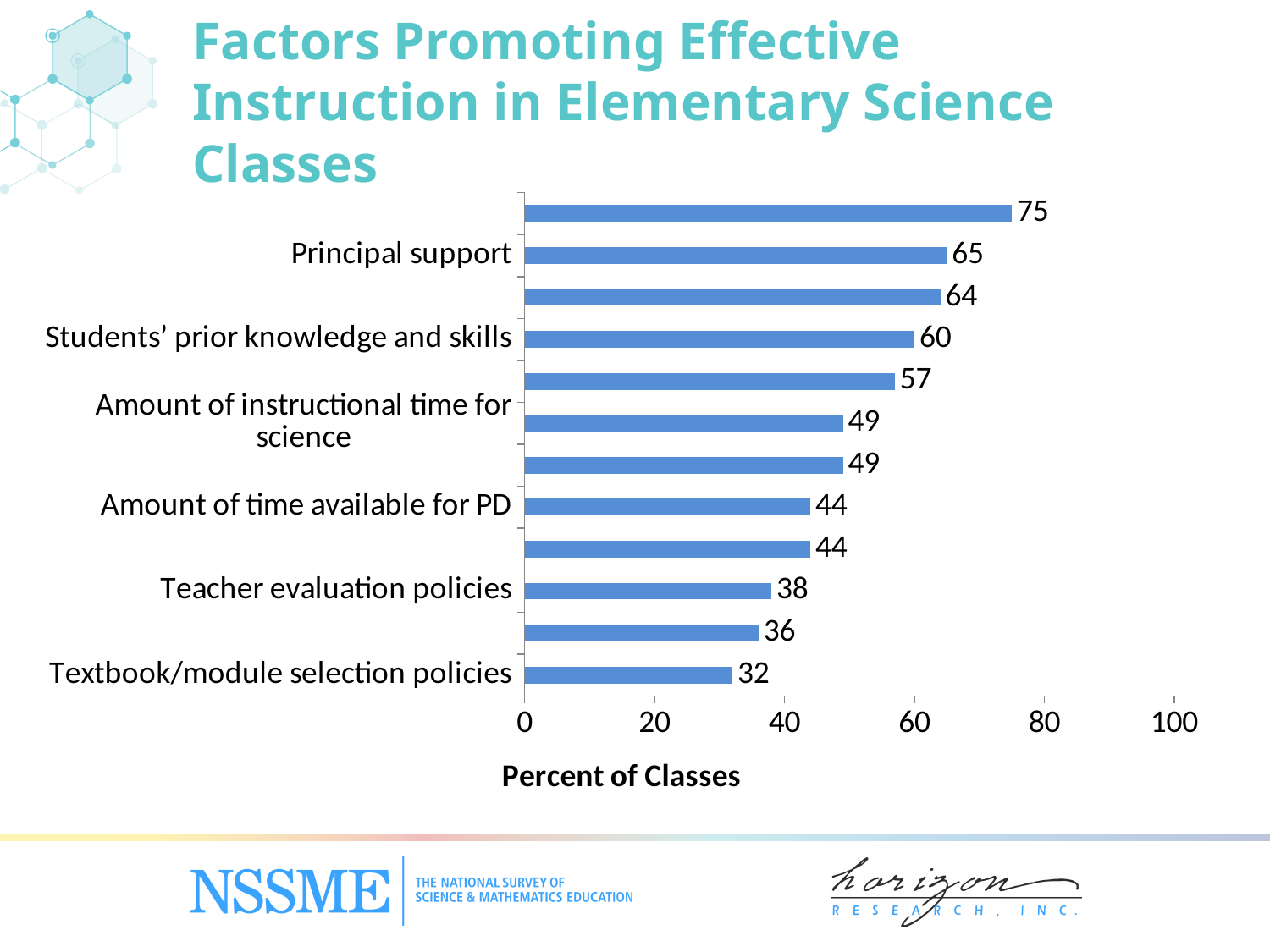
What is the value for Teacher evaluation policies? 38 Which is larger, the value for Students' prior knowledge and skills or the value for Teacher evaluation policies? Students' prior knowledge and skills Which labeled category has the lowest value? Textbook/module selection policies What is the highest value shown on the chart? 75 What is the difference between the values for Principal support and Textbook/module selection policies? 33 What is the value for Students' prior knowledge and skills? 60 What is the value for Amount of instructional time for science? 49 What kind of chart is shown on the slide? Bar chart How many bars are plotted on the chart? 12 What is the value for Amount of time available for PD? 44 What is the value for Principal support? 65 What is the title of the horizontal axis? Percent of Classes